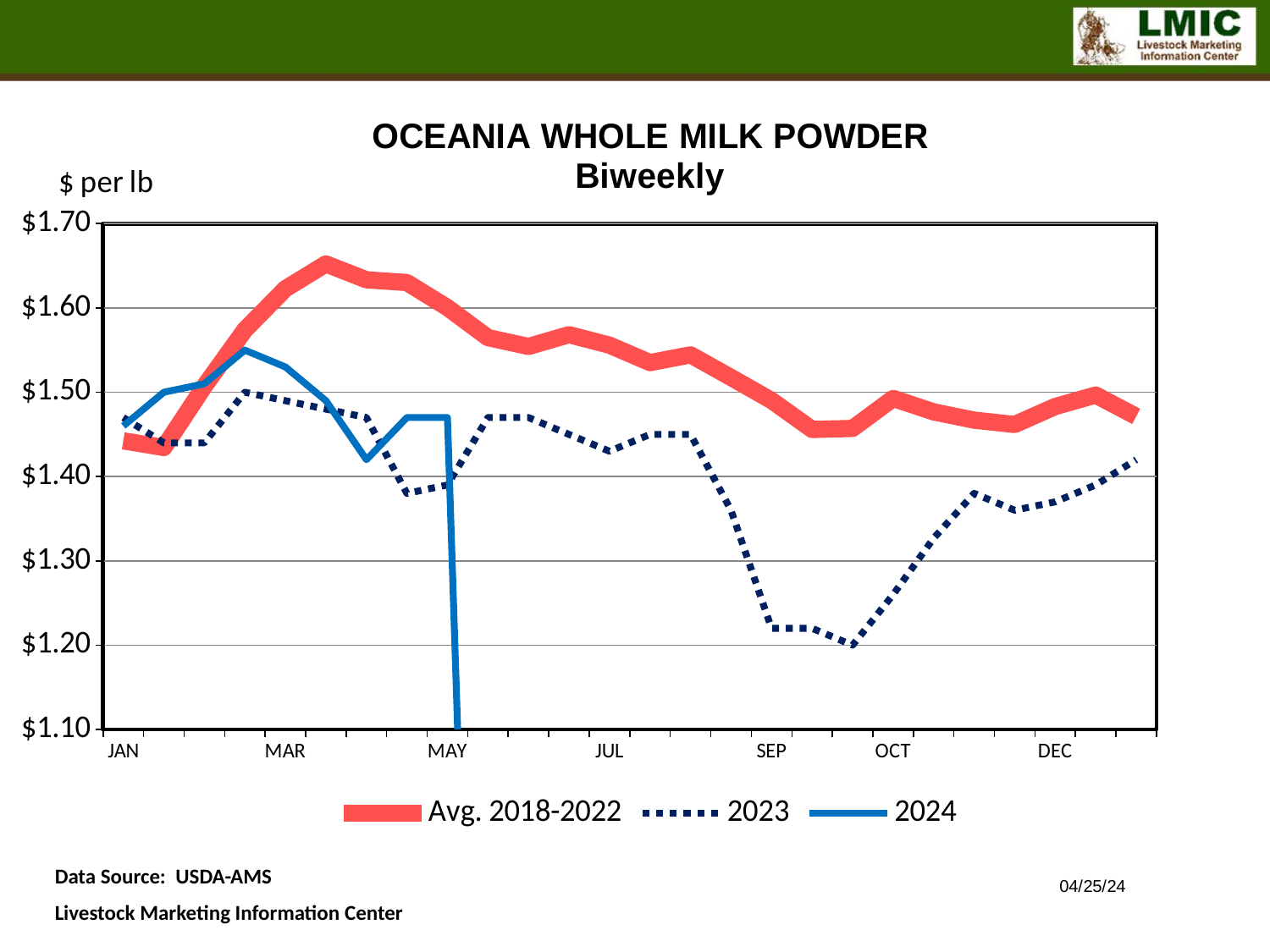
In September, which series is higher: Avg. 2018-2022 or 2023? Avg. 2018-2022 Which series reaches the highest value on the chart? Avg. 2018-2022 What is the title of the chart? OCEANIA WHOLE MILK POWDER Biweekly What kind of chart is shown on the slide? Line chart Is the 2024 value in January greater or less than $1.40? greater How many series does the legend list? 3 Is the Avg. 2018-2022 value in December greater or less than $1.50? less What unit is shown on the y axis label? $ per lb Is the 2023 value in September greater or less than $1.30? less Does the Avg. 2018-2022 line rise or fall from March to September? fall